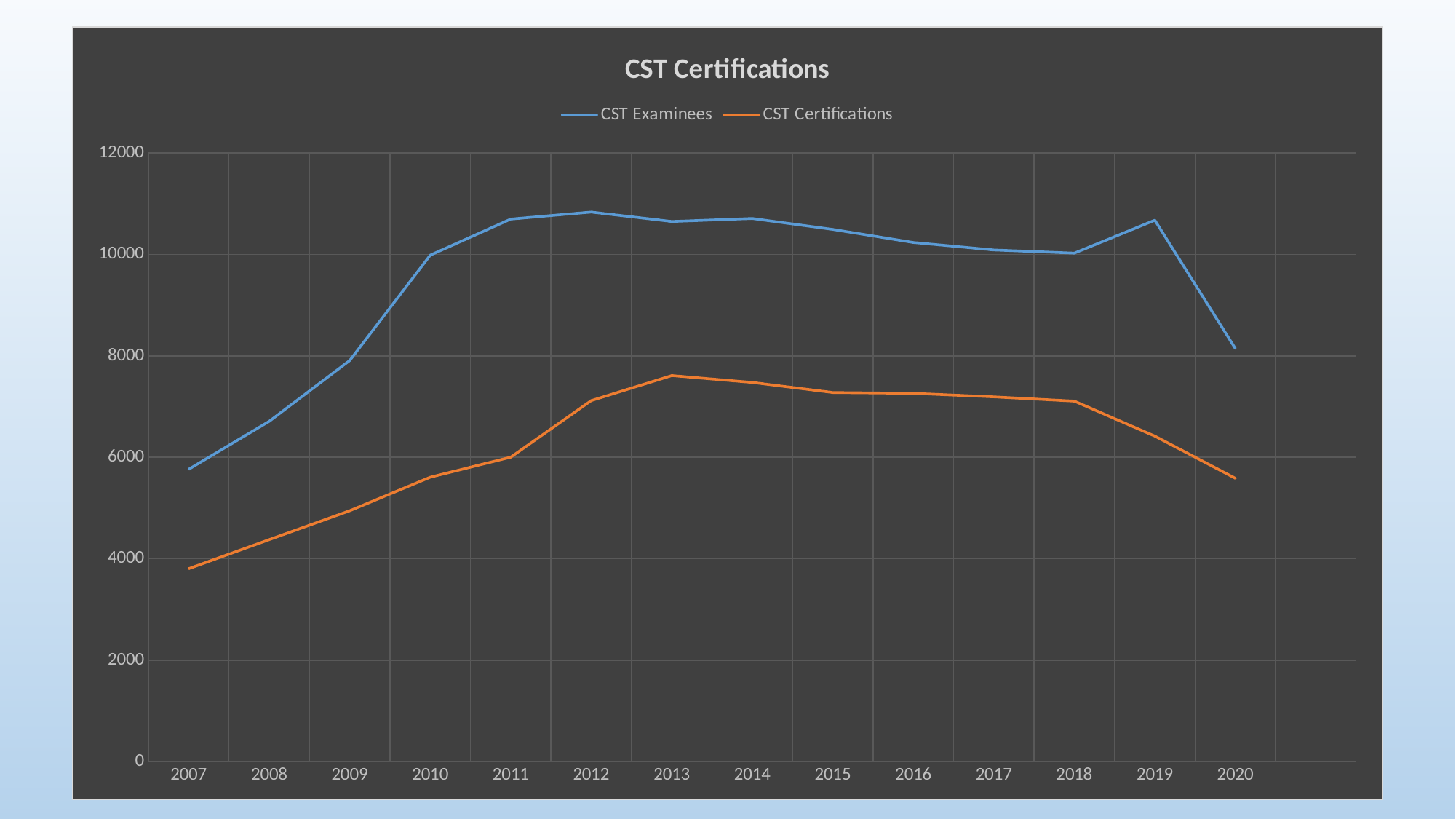
In which year is the CST Certifications value highest? 2013 What type of chart is shown on the slide? line chart Which series is drawn in orange? CST Certifications In which year is the CST Examinees value lowest? 2007 Is the CST Certifications value for 2020 greater or less than 6000? less Is the CST Examinees value for 2012 greater or less than 10000? greater In which year is the CST Certifications value lowest? 2007 What is the title of the chart? CST Certifications How many years are plotted along the x axis? 14 Do the CST Certifications values rise or fall from 2007 to 2013? rise How many series does the legend list? 2 Which is larger, the CST Examinees value for 2019 or for 2020? 2019